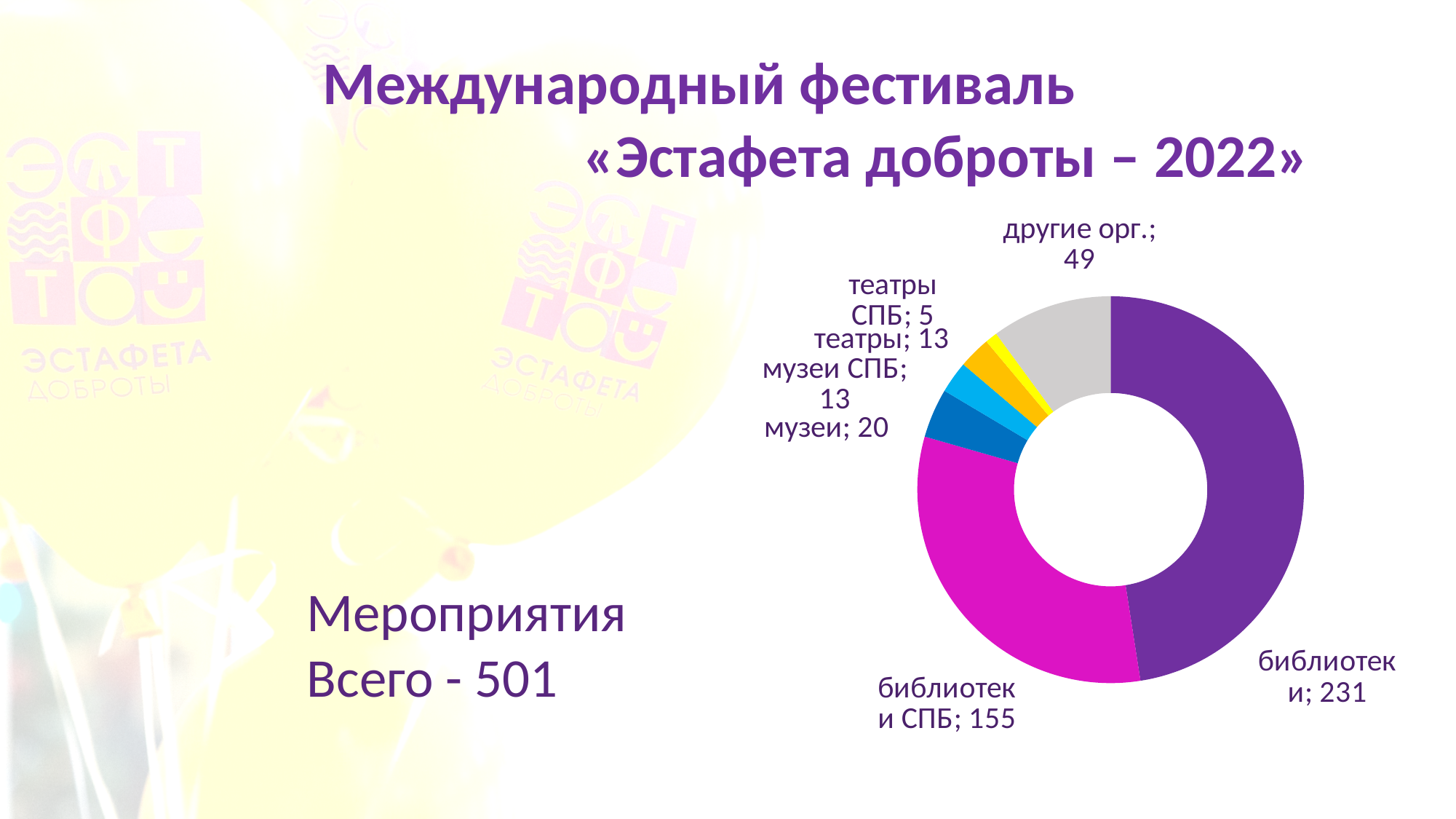
What colour is the slice for библиотеки СПБ? Magenta What kind of chart is shown on the slide? Doughnut (pie) chart What is the value for театры СПБ? 5 What is the value for библиотеки СПБ? 155 What is the difference between библиотеки and библиотеки СПБ? 76 Which category has the smallest value? театры СПБ What is the value for музеи? 20 How many events are shown for библиотеки? 231 How many categories are shown in the chart? 7 Which category has the largest value? библиотеки What is the value for другие орг.? 49 Which is larger, другие орг. or музеи? другие орг.